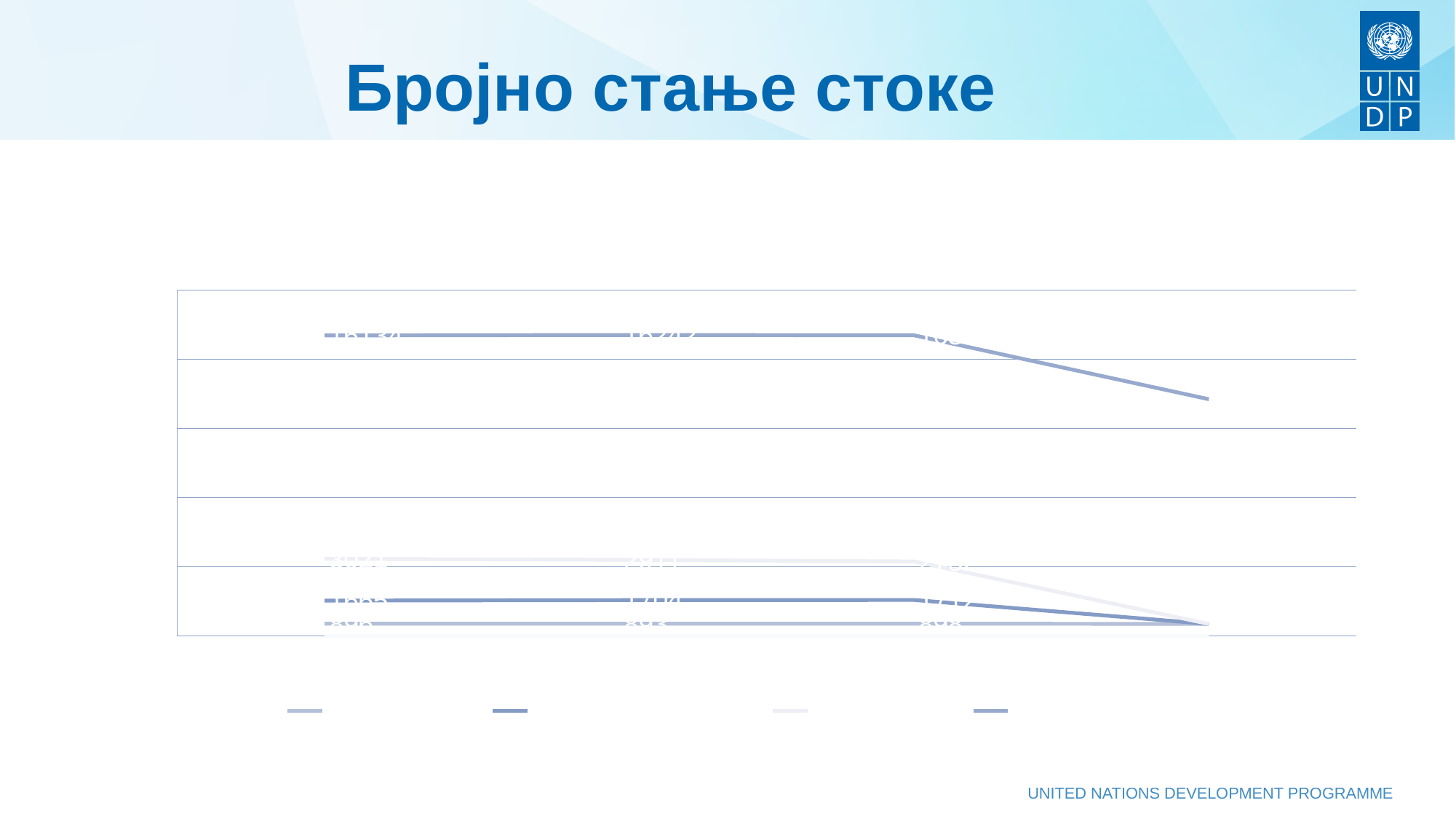
Do the values of the top line rise or fall toward the right end of the x axis? fall What is the title shown at the top of the slide containing the chart? Бројно стање стоке Does the top line in the chart rise or fall between its third and fourth points? fall How many series does the legend below the chart list? 4 What kind of chart is shown on the slide? line chart